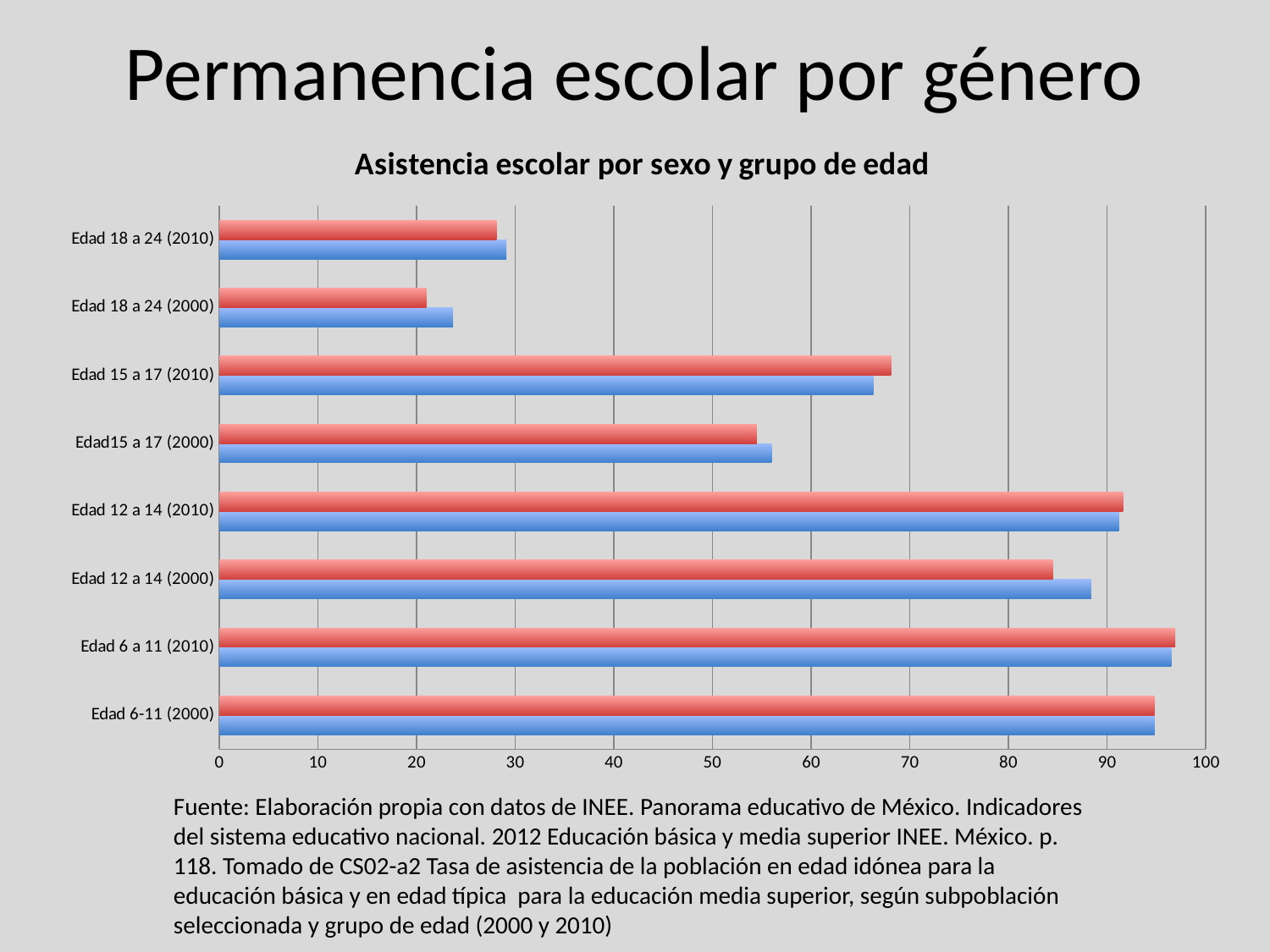
Is the value of the red bar for Edad 18 a 24 (2010) greater or less than 30? less What two colours are used for the bars in the chart? red and blue Is the value of the blue bar for Edad 18 a 24 (2000) greater or less than 20? greater For Edad 18 a 24 (2000), which bar is longer, the red one or the blue one? the blue one Is the value of the red bar for Edad 6 a 11 (2010) greater or less than 90? greater What is the title of the chart? Asistencia escolar por sexo y grupo de edad For Edad 12 a 14 (2000), which bar is longer, the red one or the blue one? the blue one What kind of chart is shown on the slide? bar chart How many age-group categories are listed on the vertical axis of the chart? 8 Which category has the shortest bars in the chart? Edad 18 a 24 (2000)